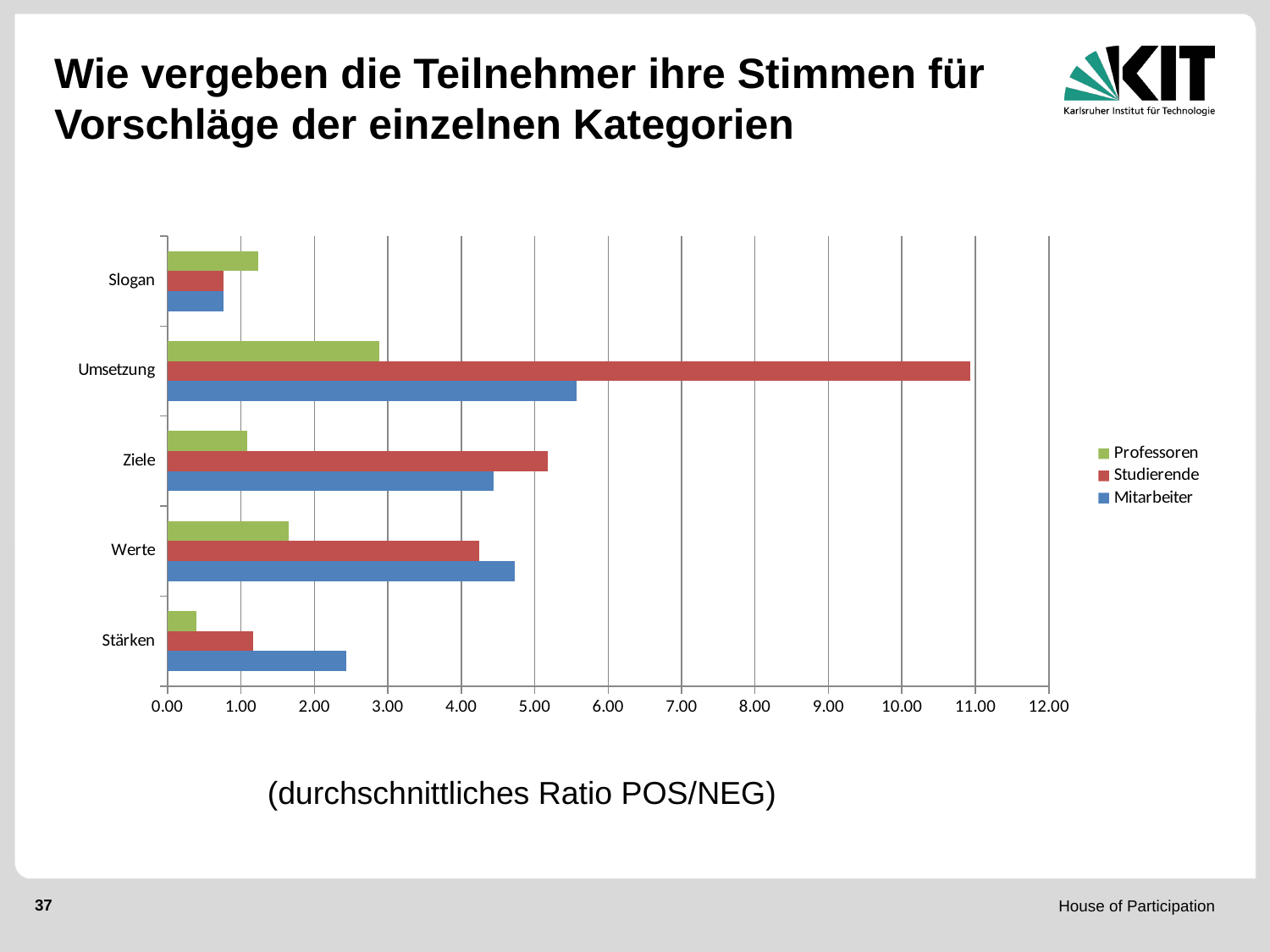
For the Professoren series, which category has the lowest value? Stärken What is the highest value shown on the horizontal axis of the chart? 12.00 Is the value for Professoren in the Stärken category greater or less than 1.00? less For the Studierende series, which category has the highest value? Umsetzung How many series does the legend list? 3 In the Ziele category, which is larger: the value for Studierende or for Mitarbeiter? Studierende Which colour represents the Mitarbeiter series in the chart? Blue What kind of chart is shown on the slide? Bar chart Is the value for Mitarbeiter in the Umsetzung category greater or less than 5.00? greater In the Stärken category, which is larger: the value for Mitarbeiter or for Studierende? Mitarbeiter How many categories are shown on the vertical axis of the chart? 5 Is the value for Studierende in the Umsetzung category greater or less than 10.00? greater